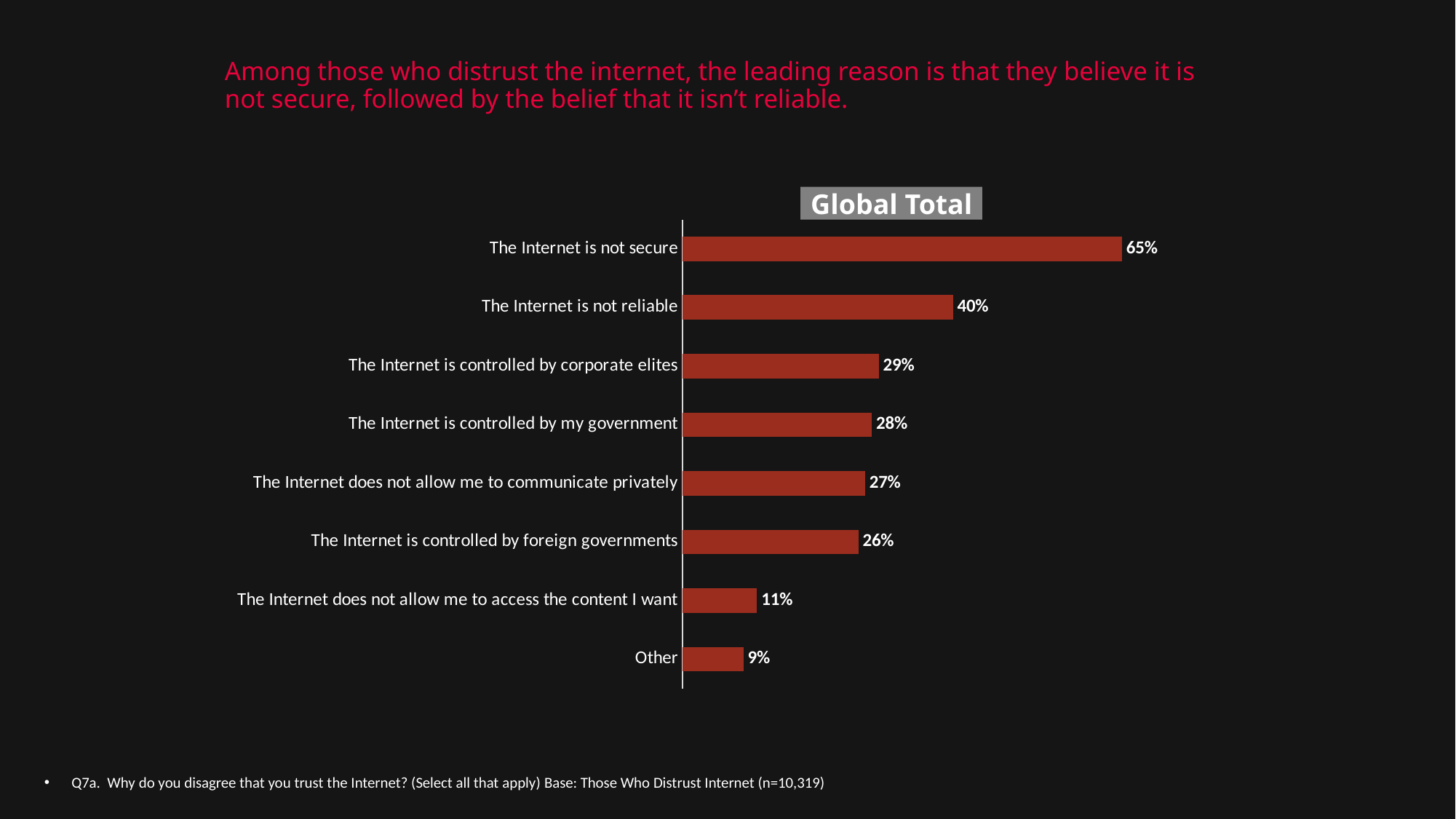
What is the difference between "The Internet is controlled by corporate elites" and "Other"? 20% What percentage of respondents said "The Internet is not secure"? 65% Which category has the lowest percentage? Other What is the value for "The Internet does not allow me to access the content I want"? 11% What kind of chart is shown on the slide? Bar chart What colour are the bars in the chart? Red Which reason has the highest percentage? The Internet is not secure What is the value for "The Internet is controlled by my government"? 28% What is the difference between "The Internet is not secure" and "The Internet is not reliable"? 25% How many categories are shown in the chart? 8 Which is larger: "The Internet is not reliable" or "The Internet is controlled by foreign governments"? The Internet is not reliable What is the title of the chart? Global Total